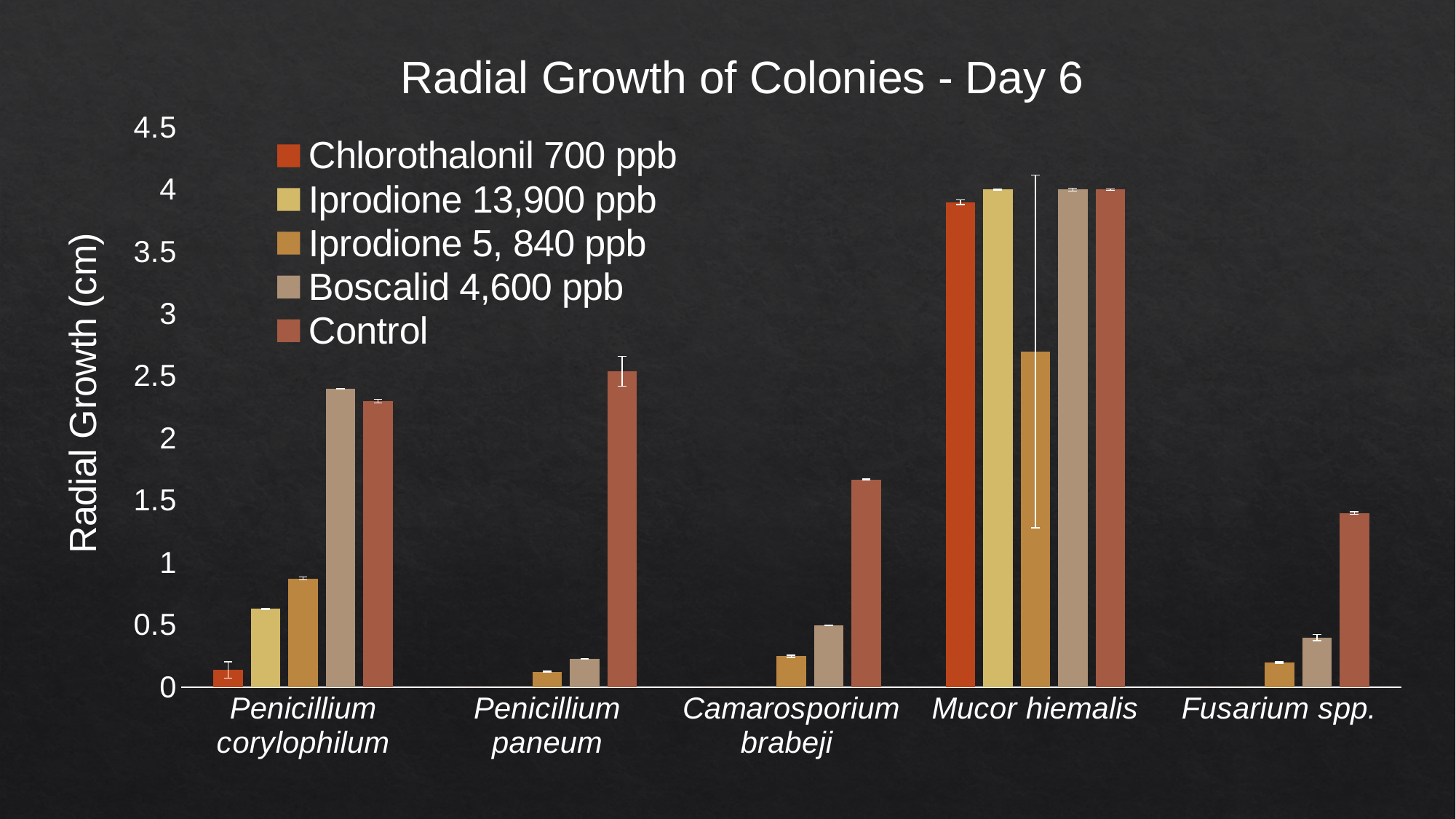
Is the Control value for Fusarium spp. greater or less than 1? greater How many fungal species categories are shown on the x axis? 5 Which species has the highest Control bar? Mucor hiemalis What is the label of the y axis? Radial Growth (cm) What kind of chart is shown on the slide? Bar chart How many series does the legend list? 5 Which species has the lowest Control bar? Fusarium spp. Is the Boscalid 4,600 ppb value for Camarosporium brabeji greater or less than 1? less Is the Control value for Penicillium paneum greater or less than 2? greater For Mucor hiemalis, which is larger: the Iprodione 5, 840 ppb bar or the Boscalid 4,600 ppb bar? Boscalid 4,600 ppb For Penicillium corylophilum, which is larger: the Iprodione 13,900 ppb bar or the Iprodione 5, 840 ppb bar? Iprodione 5, 840 ppb